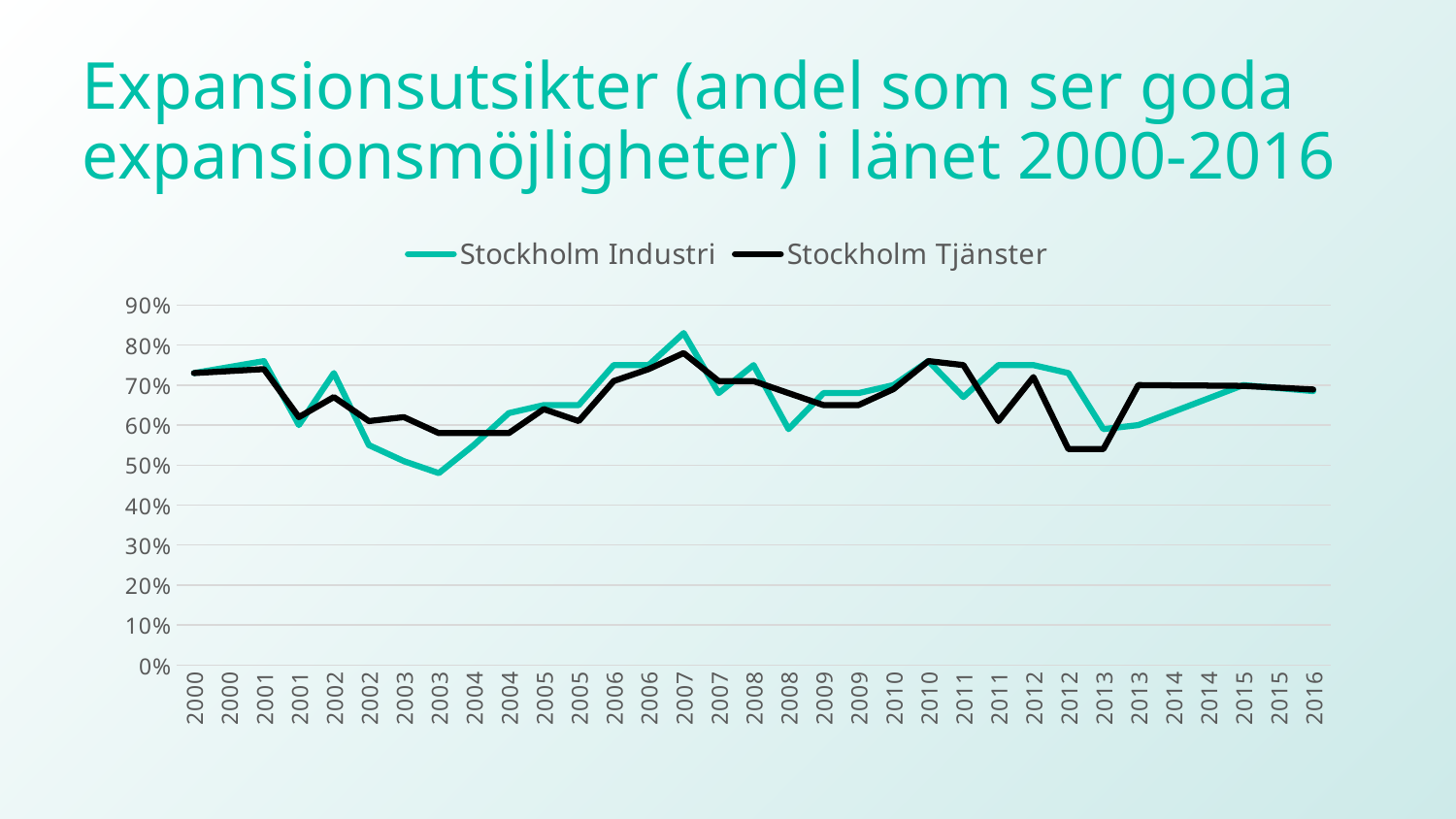
At the second 2003 point, which series has the higher value, Stockholm Industri or Stockholm Tjänster? Stockholm Tjänster Which series is drawn in black? Stockholm Tjänster Is the peak value of Stockholm Industri in 2007 greater or less than 80%? greater How many series does the legend list? 2 What is the first year shown on the x axis? 2000 In which year does Stockholm Industri reach its highest value? 2007 What are the two series named in the legend? Stockholm Industri and Stockholm Tjänster Is the value of Stockholm Tjänster at the end of 2012 greater or less than 60%? less Is the lowest value of Stockholm Industri (in 2003) greater or less than 50%? less What kind of chart is shown on the slide? line chart What is the last year shown on the x axis? 2016 What is the highest value shown on the y axis? 90%